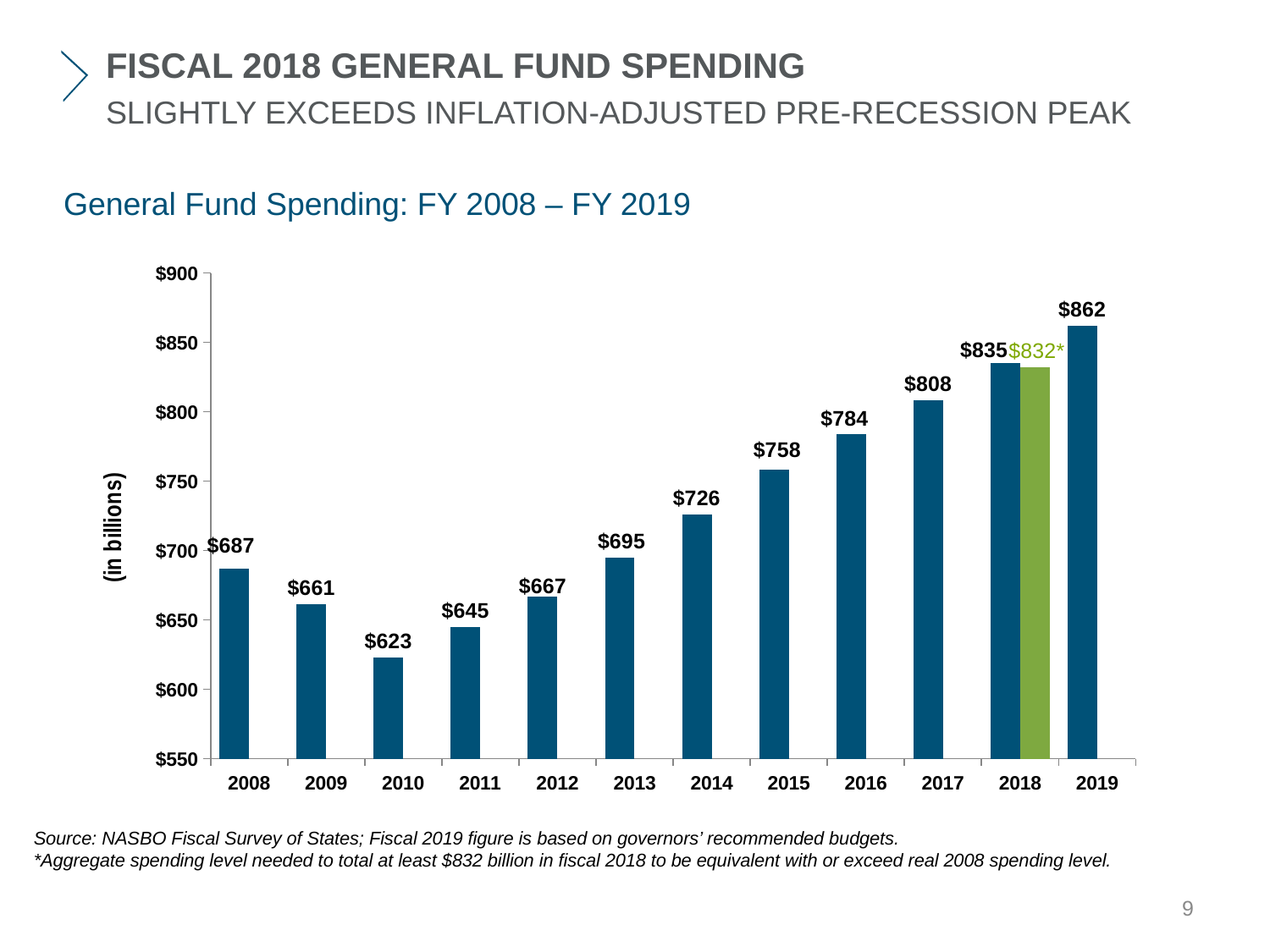
Do the values rise or fall from 2010 to 2019? rise What is the label on the vertical axis? (in billions) What value is shown by the green bar for 2018? $832* What kind of chart is this? bar chart What is the difference between the 2018 blue bar value and the 2017 value? $27 Which year has the lowest general fund spending? 2010 What is the difference between the 2019 value and the 2008 value? $175 Which year has the highest general fund spending? 2019 What is the general fund spending value for 2016? $784 How many years are shown on the x axis? 12 What is the general fund spending value for 2010? $623 Which is larger, the value for 2009 or the value for 2011? 2009